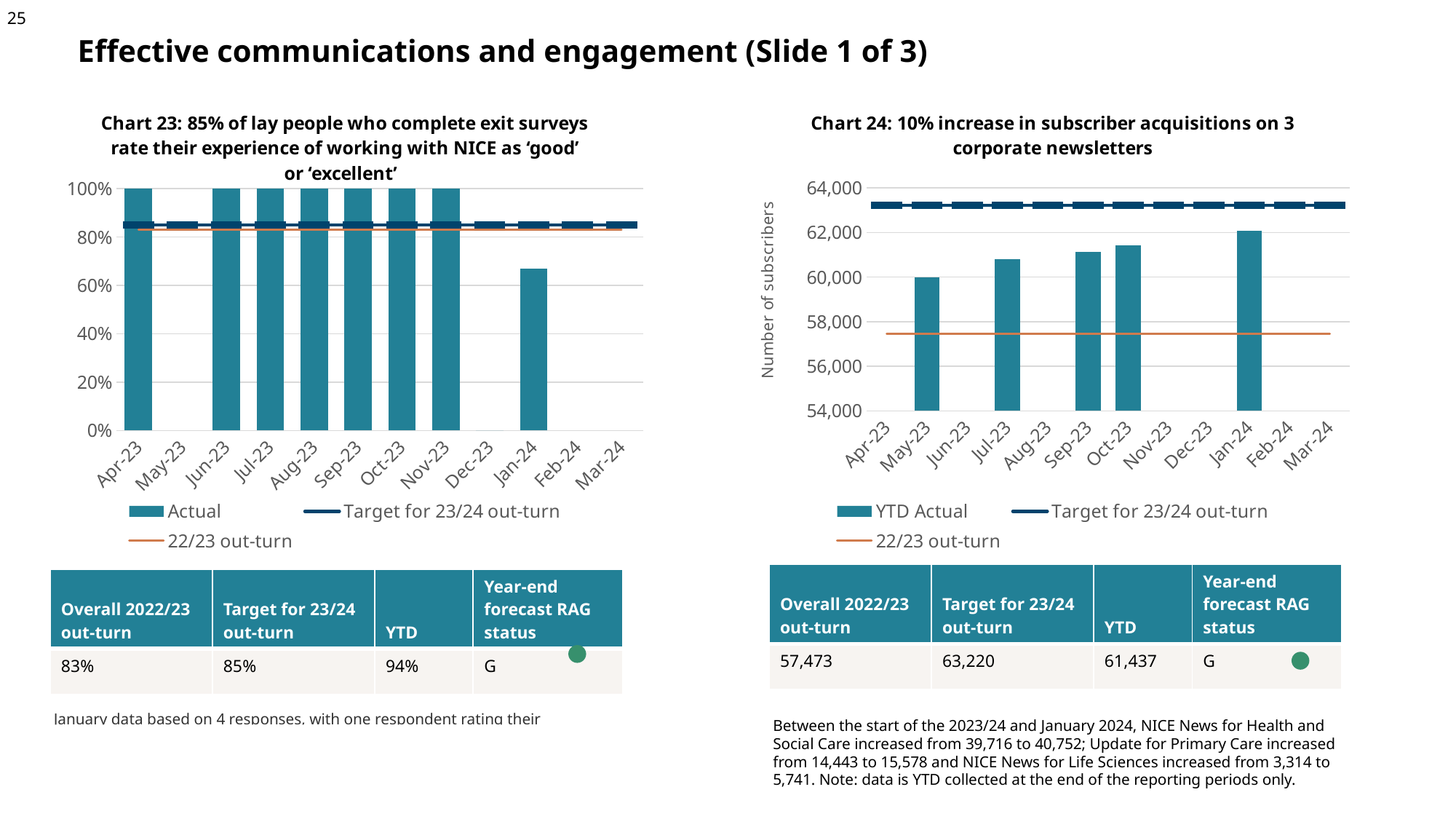
What is the y-axis title of Chart 24? Number of subscribers In Chart 23, what is the Actual value for Apr-23? 100% How many months are shown on the x axis of Chart 23? 12 In Chart 24, which month has the lowest YTD Actual bar? May-23 In Chart 24, do the YTD Actual bars rise or fall from May-23 to Jan-24? rise How many series does the legend of Chart 24 list? 3 What kind of chart is Chart 23? Combination bar and line chart In Chart 23, which month has the lowest Actual bar? Jan-24 In Chart 24, is the YTD Actual value for Jul-23 greater or less than 60,000? greater How many series does the legend of Chart 23 list? 3 In Chart 24, which month has the highest YTD Actual bar? Jan-24 In Chart 23, is the Actual value for Jan-24 greater or less than 80%? less